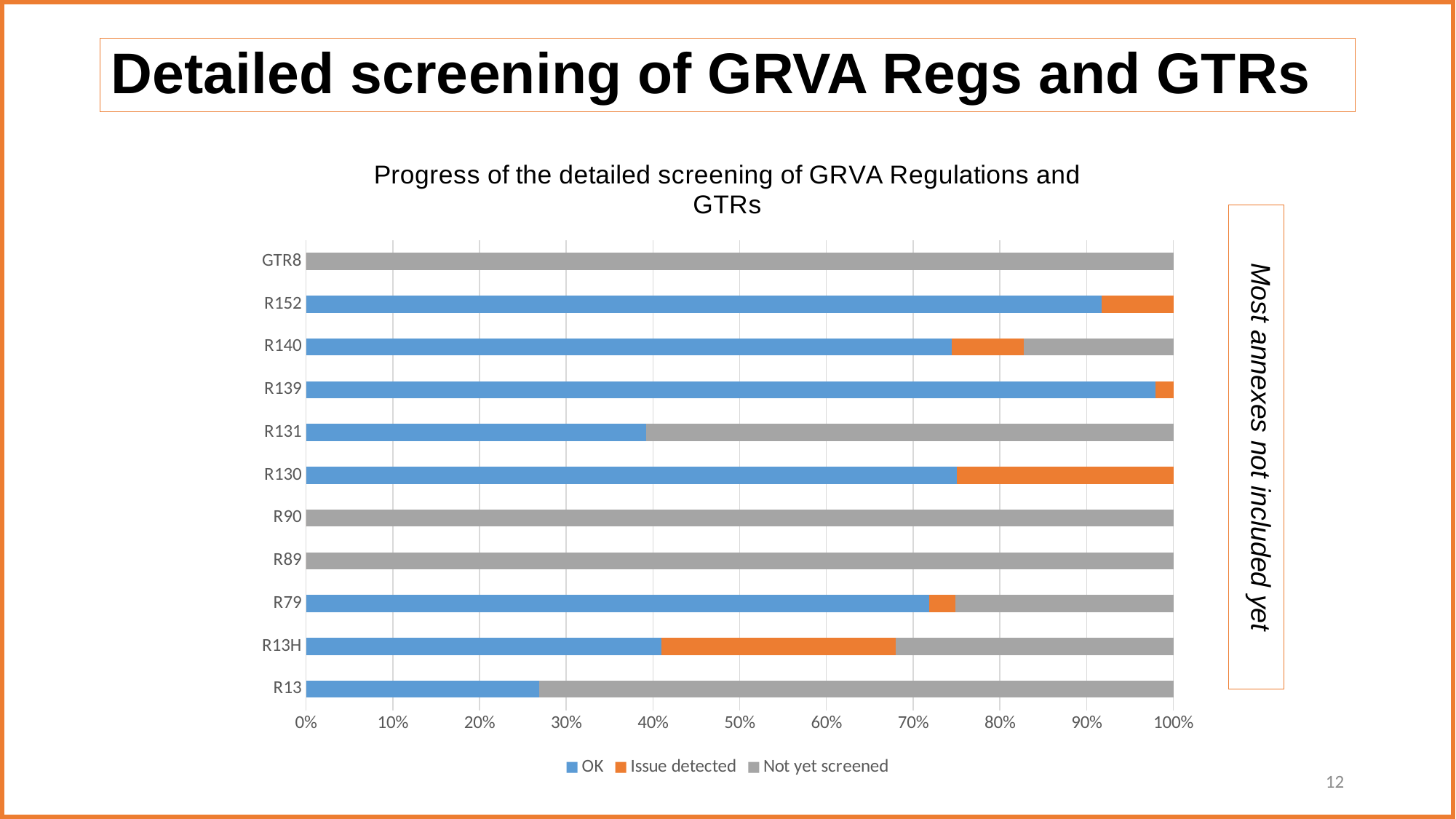
What kind of chart is shown on the slide? Bar chart (stacked) Is the OK share for R152 greater or less than 90%? greater Which series is shown in orange in the chart? Issue detected How many categories are shown as entirely Not yet screened? 3 What is the title of the chart? Progress of the detailed screening of GRVA Regulations and GTRs Which category has the largest Issue detected share? R13H Which category has the largest OK share? R139 How many series does the chart legend list? 3 Which has the larger OK share, R13 or R131? R131 Is the OK share for R130 greater or less than 70%? greater How many categories (regulations/GTRs) are listed on the vertical axis of the chart? 11 Is the OK share for R13 greater or less than 30%? less